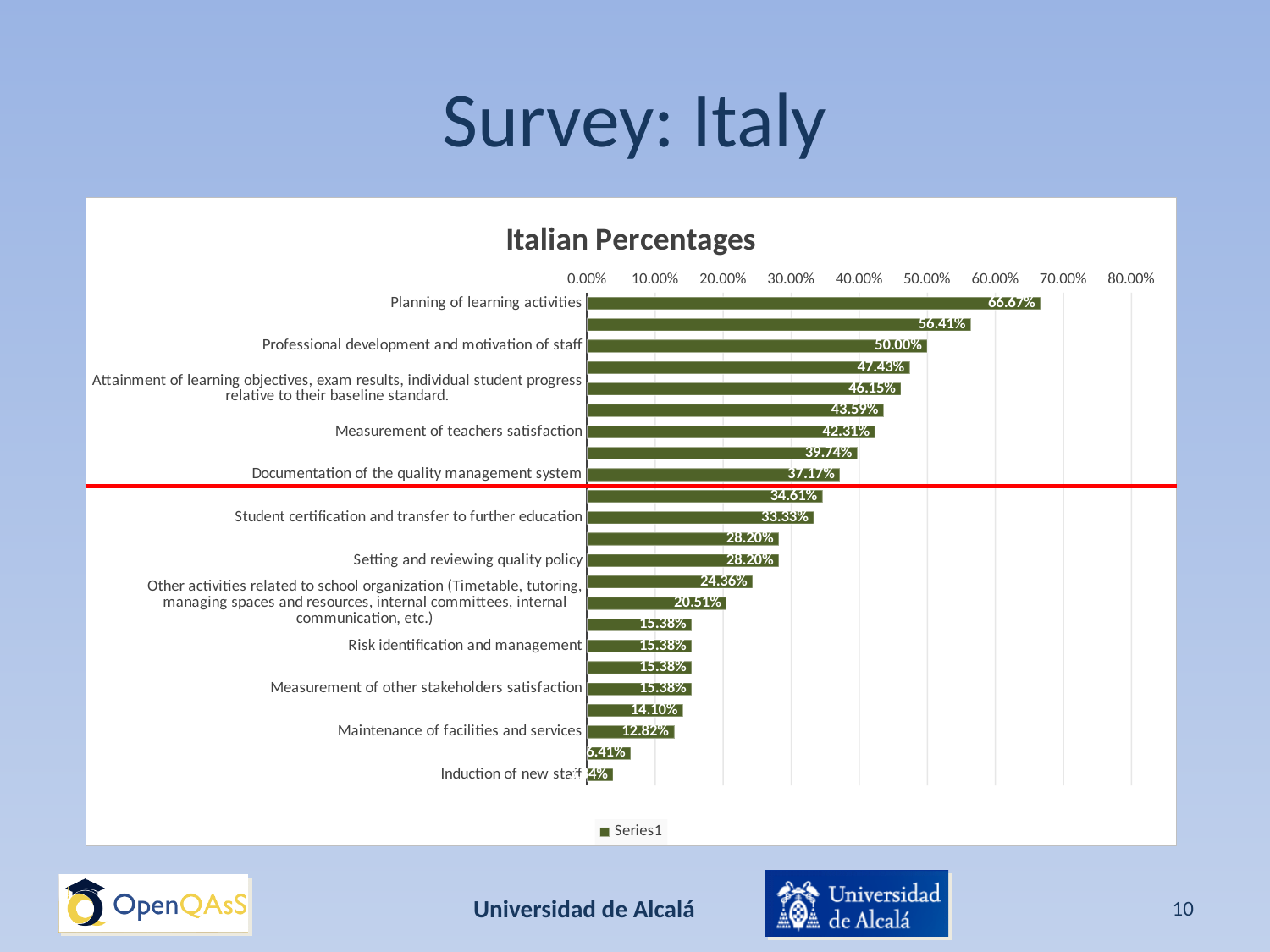
What is the value for Measurement of teachers satisfaction? 42.31% What is the value for Professional development and motivation of staff? 50.00% How many series does the legend list? 1 What is the value for Planning of learning activities? 66.67% What is the title of the chart? Italian Percentages What is the value for Documentation of the quality management system? 37.17% Which category has the highest value? Planning of learning activities Which is larger: Student certification and transfer to further education or Setting and reviewing quality policy? Student certification and transfer to further education Is the value for Risk identification and management greater or less than 20.00%? less What type of chart is shown on the slide? Bar chart What is the difference between Planning of learning activities and Professional development and motivation of staff? 16.67% What is the value for Maintenance of facilities and services? 12.82%